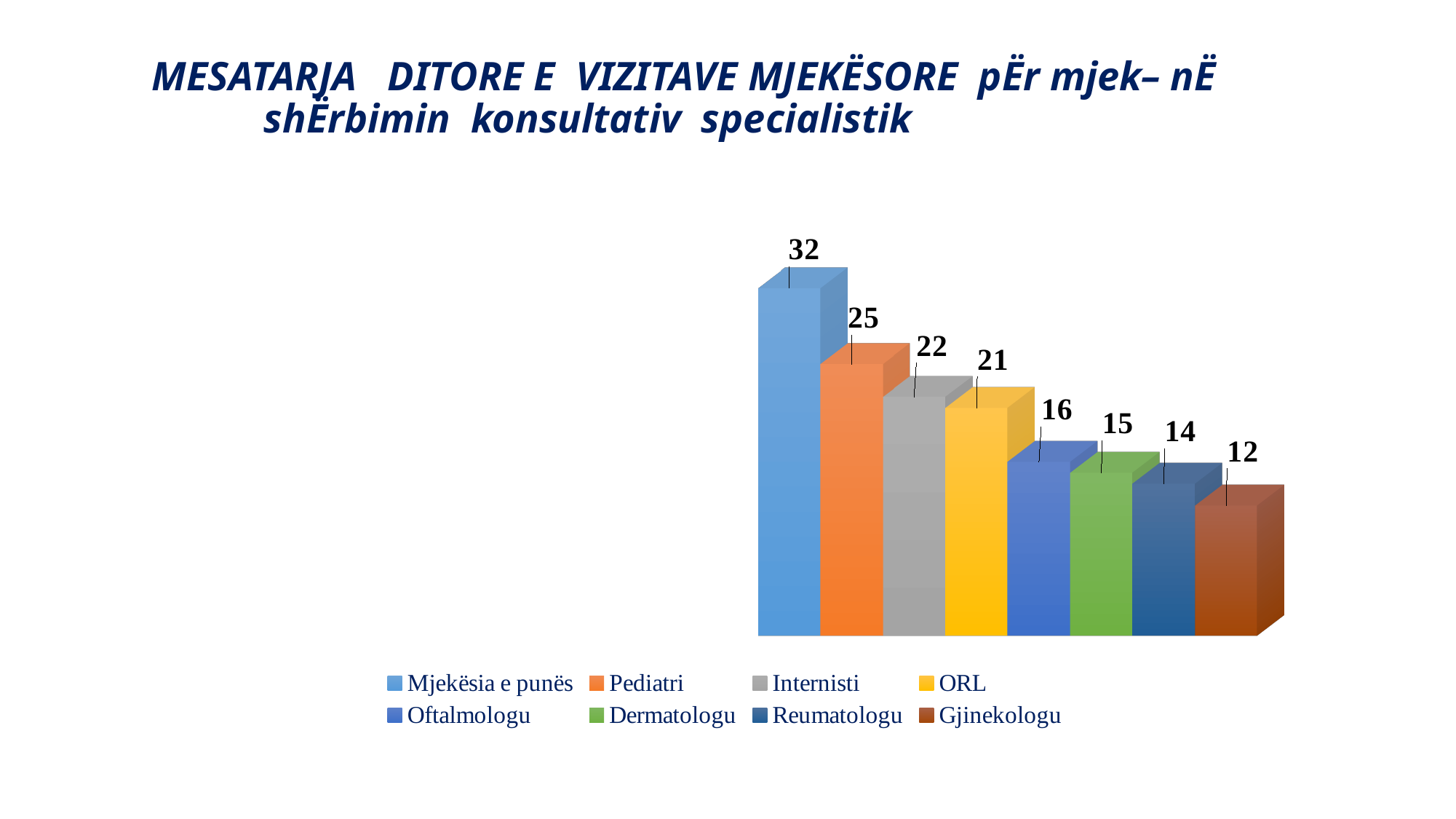
What is the value for Mjekësia e punës? 32 What is the value for ORL? 21 How many categories are shown in the chart? 8 What is the difference between the values for Mjekësia e punës and Pediatri? 7 What is the value for Pediatri? 25 Do the values rise or fall from left to right across the bars? Fall Which category has the highest value? Mjekësia e punës Which category has the lowest value? Gjinekologu What is the value for Gjinekologu? 12 Which is larger, the value for Dermatologu or the value for Reumatologu? Dermatologu What is the difference between the values for Internisti and Oftalmologu? 6 What kind of chart is shown on the slide? Bar chart